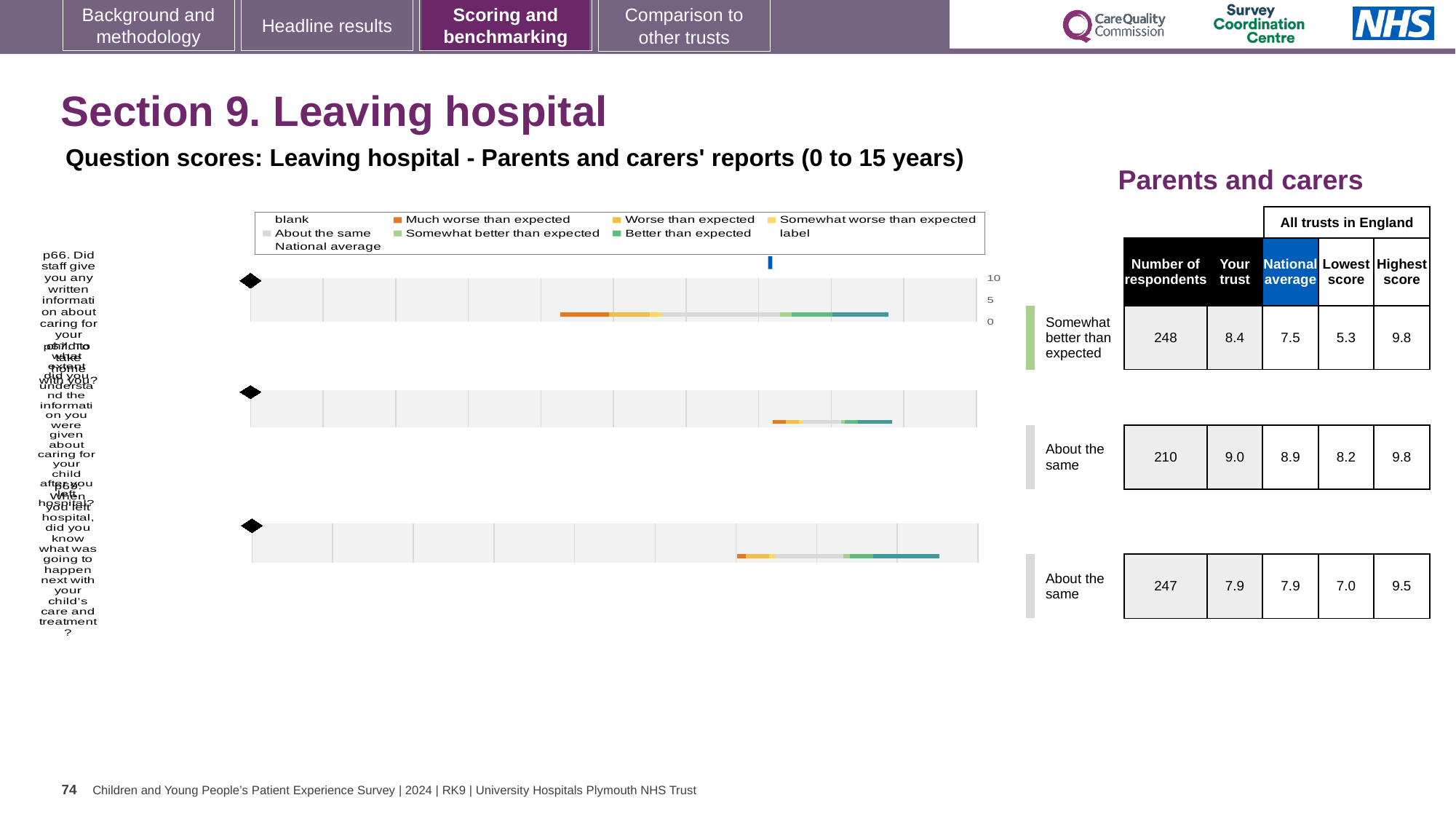
In the table beside the charts, what is the number of respondents for the third row? 247 How many entries does the chart legend list? 9 In the table beside the charts, what is the lowest score for the third row? 7.0 In the first row of the table beside the charts, which is larger: the 'Your trust' score or the national average? Your trust In the table beside the charts, what is the 'Your trust' score for the first row (Somewhat better than expected)? 8.4 How many question score bars (charts) are shown on the slide? 3 In the table beside the charts, what is the national average for the second row (About the same)? 8.9 What kind of chart is used to show the question scores on this slide? bar chart What is the highest tick value shown on the chart axis? 10 In the table beside the charts, what is the difference between 'Your trust' and the national average in the second row? 0.1 Which row in the table beside the charts has the highest 'Your trust' score? the second row (About the same), 9.0 What colour does the legend use for 'Much worse than expected'? orange